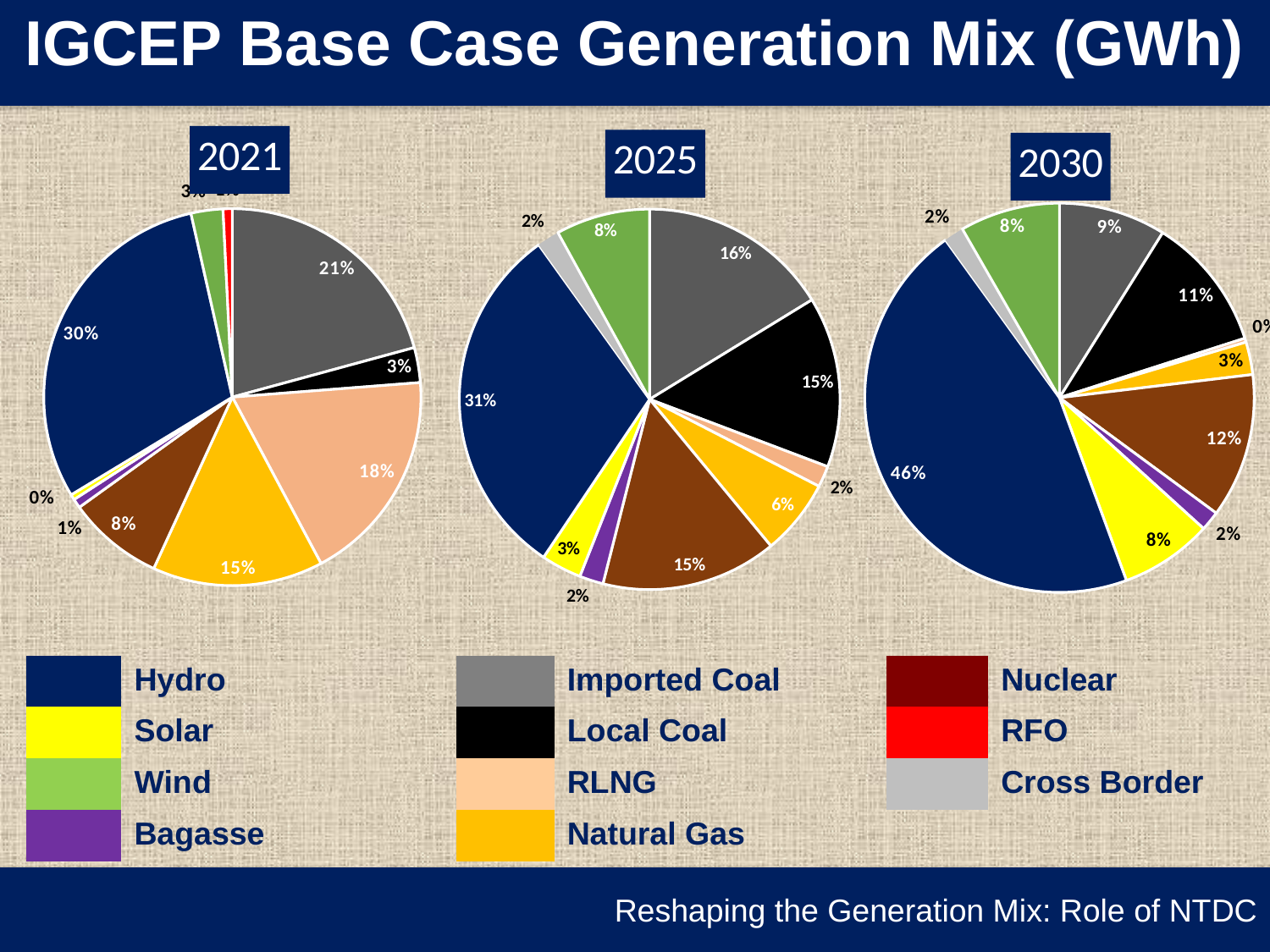
What kind of charts are shown on the slide? Pie charts In the 2025 pie chart, what share does Local Coal have? 15% What is the title of the slide? IGCEP Base Case Generation Mix (GWh) In the 2030 pie chart, what is the difference between the Hydro share and the Local Coal share? 35% In the 2030 pie chart, what share does Nuclear have? 12% In the 2025 pie chart, which source has the largest share? Hydro In the 2030 pie chart, what share does Hydro have? 46% How many sources does the legend list? 11 In the 2021 pie chart, what share does Hydro have? 30% In the 2025 pie chart, what is the difference between the Imported Coal share and the Wind share? 8% In the 2021 pie chart, what share does RLNG have? 18% In the 2021 pie chart, which is larger, Imported Coal or Natural Gas? Imported Coal